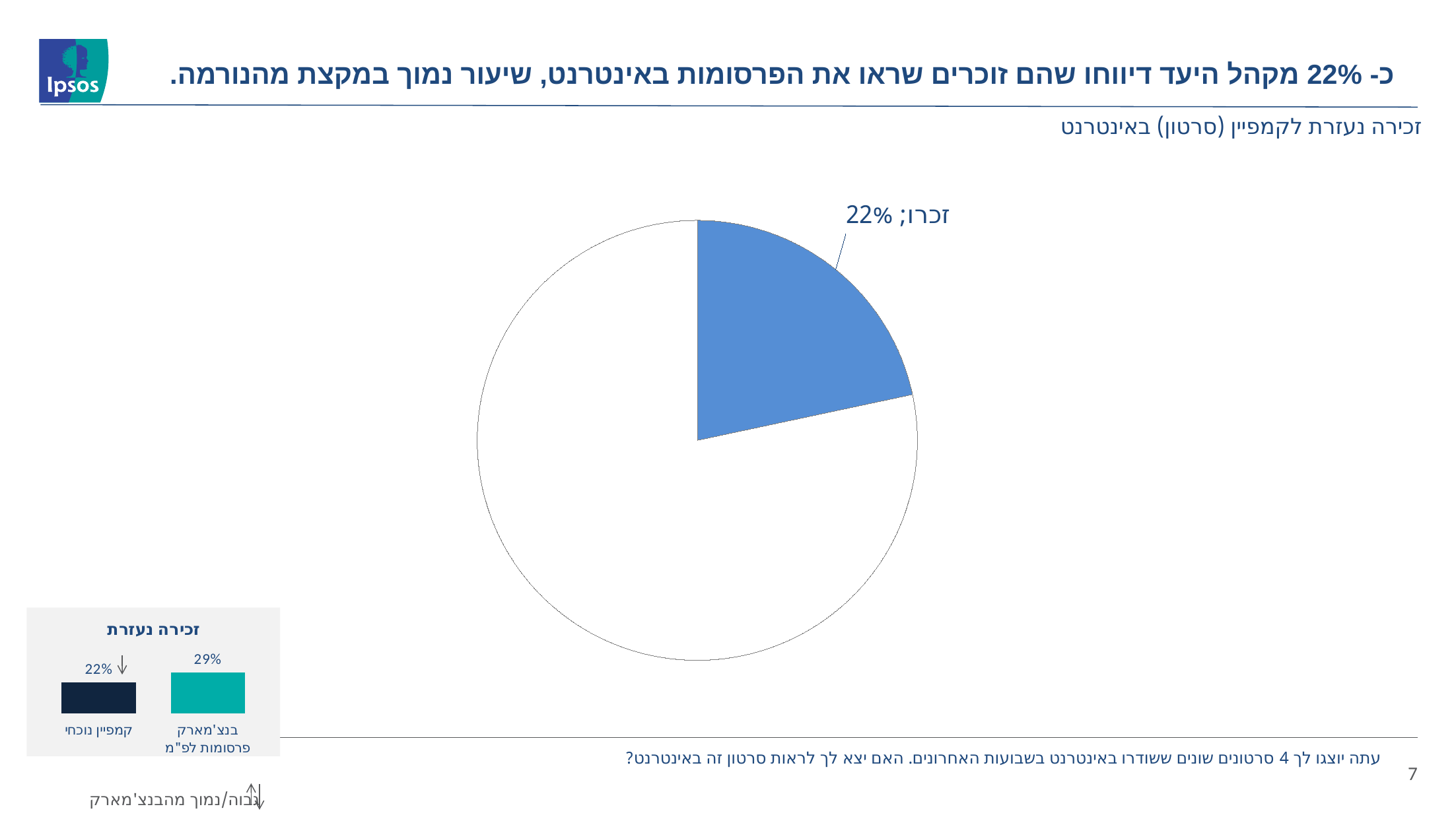
In the small bar chart at the bottom left (זכירה נעזרת), what is the difference between the benchmark value and the current campaign value? 7 percentage points In the small bar chart at the bottom left (זכירה נעזרת), which category has the lower value? קמפיין נוכחי In the pie chart, what share of the pie does the זכרו slice represent? 22% In the pie chart, what percentage is shown for the slice labelled זכרו? 22% What kind of chart is the large chart in the centre of the slide? Pie chart In the small bar chart at the bottom left (זכירה נעזרת), what is the value for בנצ'מארק פרסומות לפ"מ? 29% In the small bar chart at the bottom left (זכירה נעזרת), how many bars are shown? 2 In the small bar chart at the bottom left (זכירה נעזרת), what is the value for קמפיין נוכחי? 22% What kind of chart is the small chart at the bottom left of the slide? Bar chart In the small bar chart at the bottom left (זכירה נעזרת), which category has the higher value? בנצ'מארק פרסומות לפ"מ What is the title shown above the pie chart? זכירה נעזרת לקמפיין (סרטון) באינטרנט In the pie chart, what colour is the זכרו slice? Blue